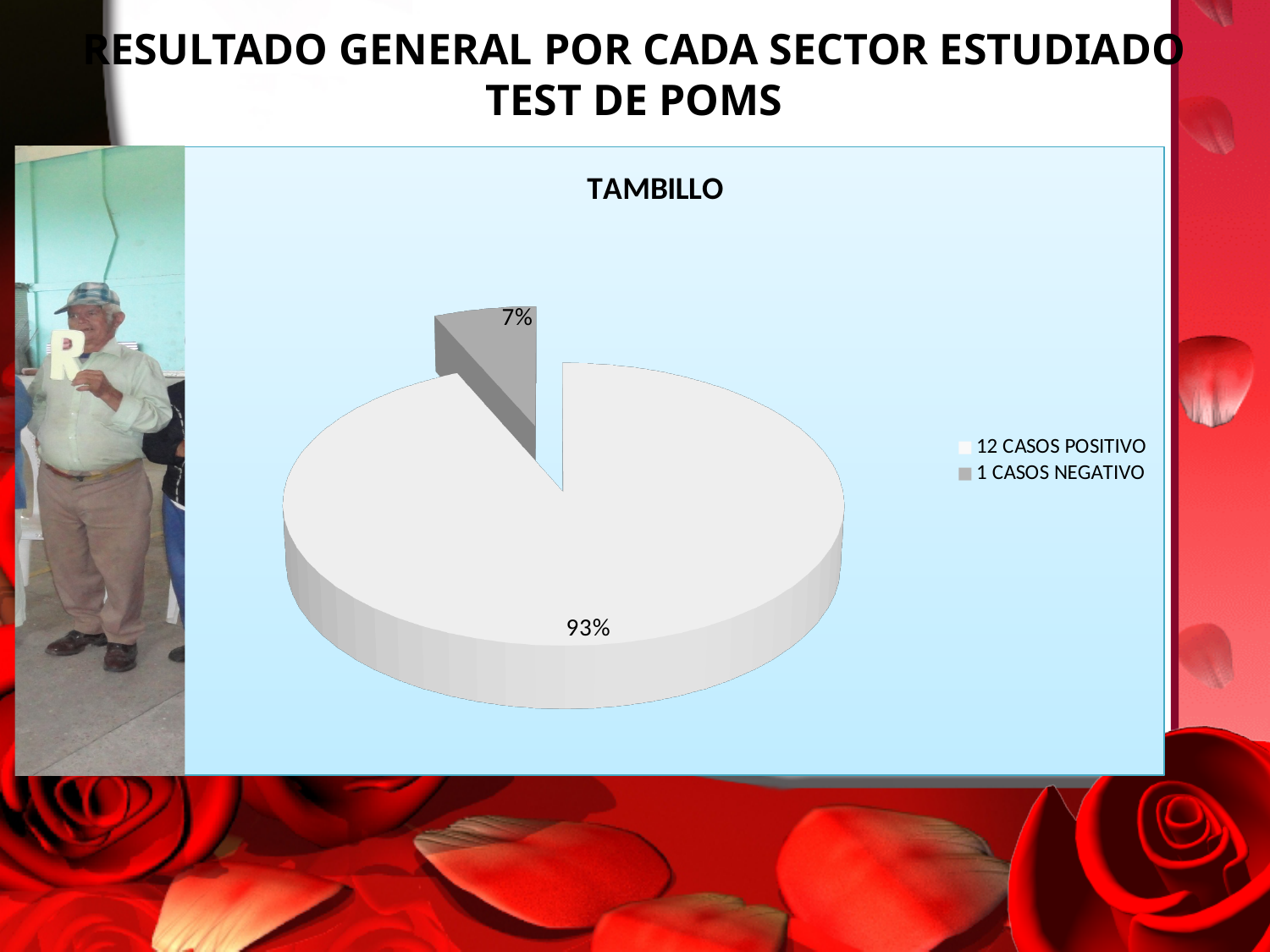
What percentage share does the '12 CASOS POSITIVO' slice have? 93% What percentage share does the '1 CASOS NEGATIVO' slice have? 7% Which is larger, the '12 CASOS POSITIVO' slice or the '1 CASOS NEGATIVO' slice? 12 CASOS POSITIVO Which slice is the largest in the pie chart? 12 CASOS POSITIVO Which slice is the smallest in the pie chart? 1 CASOS NEGATIVO What is the title of the chart? TAMBILLO How many slices does the pie chart have? 2 What is the difference in percentage points between the '12 CASOS POSITIVO' slice and the '1 CASOS NEGATIVO' slice? 86 How many entries does the legend list? 2 What kind of chart is shown on the slide? pie chart Which legend entry is shown in the darker grey colour? 1 CASOS NEGATIVO